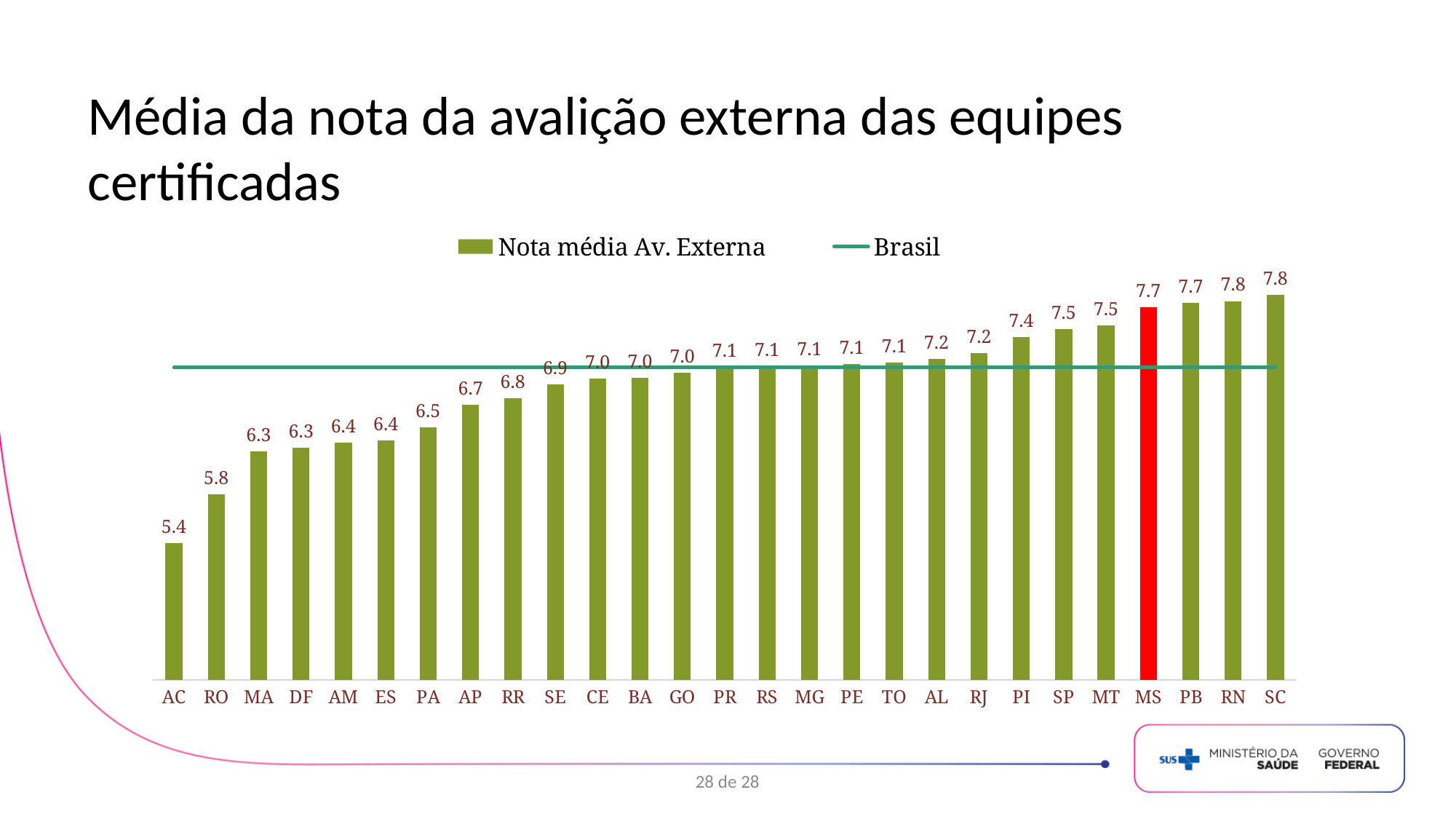
Do the bar values rise or fall from left to right along the x axis? rise What is the difference between the values for MT and PA? 1.0 What is the value for MS? 7.7 Which has a larger value, RO or MA? MA Which state has the lowest value? AC Which state's bar is coloured red? MS What kind of chart is this? combination bar and line chart How many series does the legend list? 2 What is the value for PI? 7.4 What is the value for AC? 5.4 How many states are shown on the x axis? 27 What is the difference between the values for SC and AC? 2.4